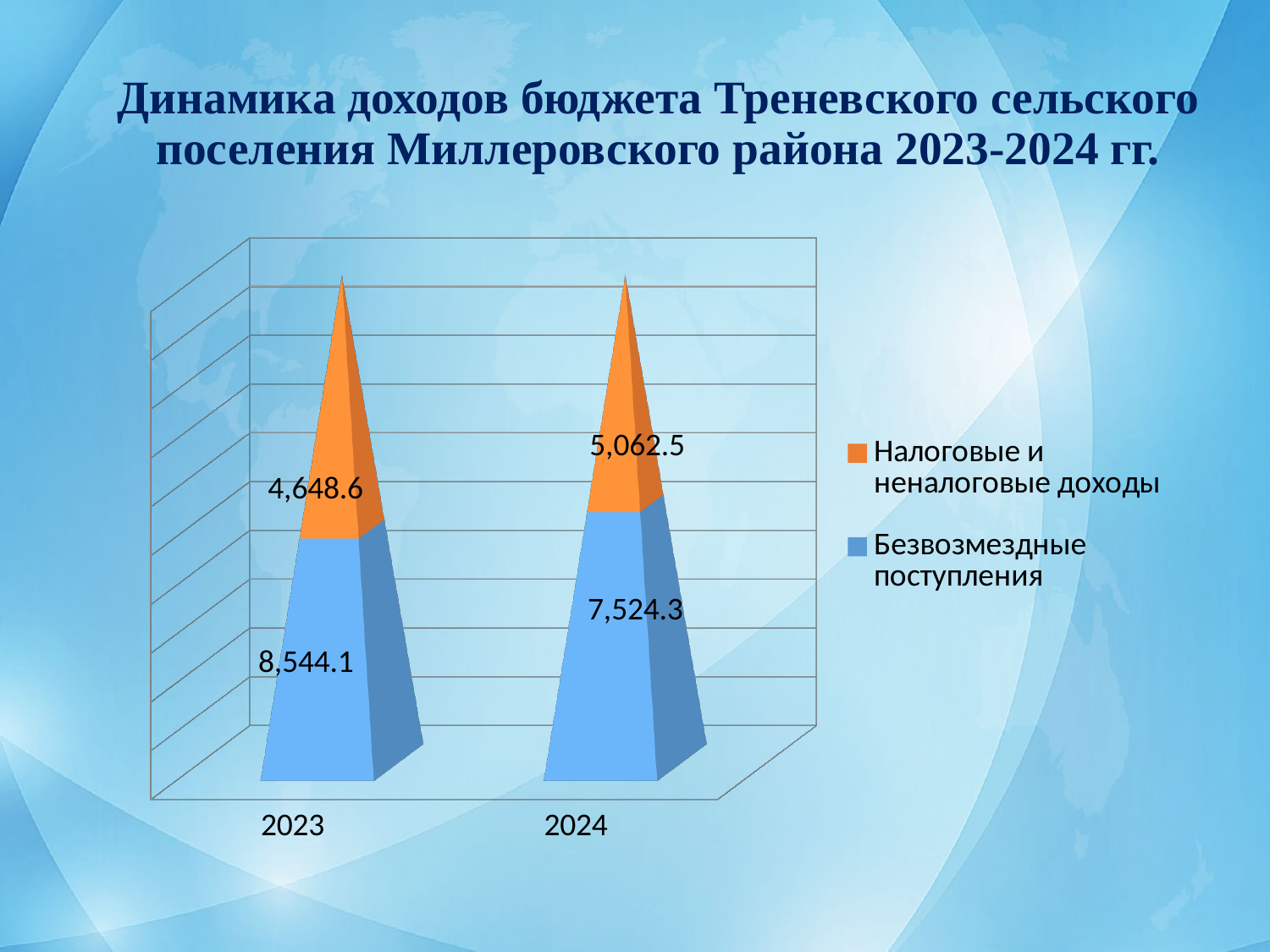
What is the total of the stacked bar for 2023? 13,192.7 In which year is Налоговые и неналоговые доходы lower? 2023 By how much did Налоговые и неналоговые доходы increase from 2023 to 2024? 413.9 What is the value of Безвозмездные поступления for 2024? 7,524.3 How many series does the legend list? 2 What is the total of the stacked bar for 2024? 12,586.8 What is the value of Налоговые и неналоговые доходы for 2023? 4,648.6 In which year is Безвозмездные поступления higher? 2023 What is the difference between Безвозмездные поступления in 2023 and 2024? 1,019.8 What is the value of Налоговые и неналоговые доходы for 2024? 5,062.5 Which is larger in 2024: Налоговые и неналоговые доходы or Безвозмездные поступления? Безвозмездные поступления What is the value of Безвозмездные поступления for 2023? 8,544.1